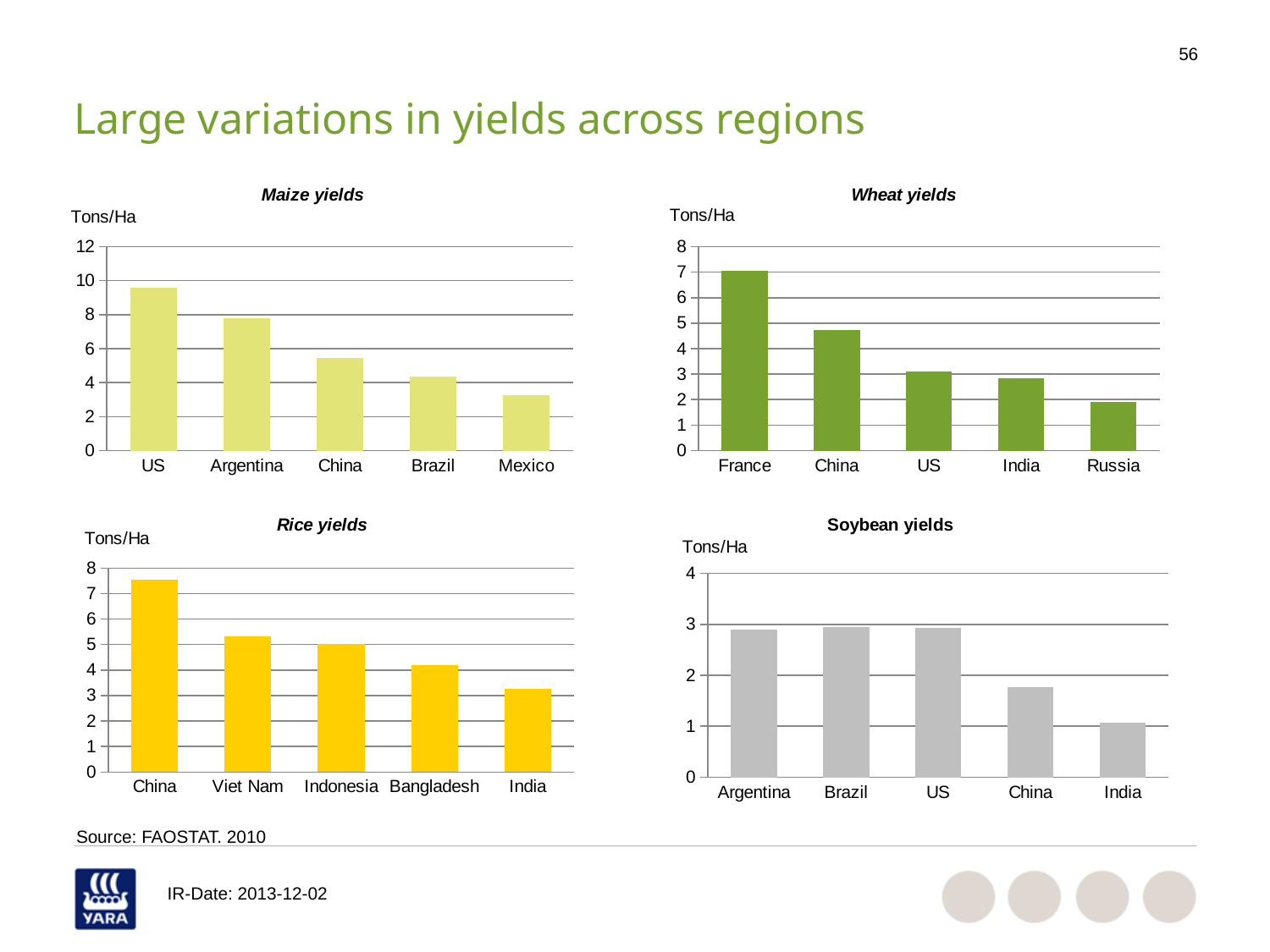
In the Soybean yields chart, which country has the lowest yield? India How many countries are shown in the Rice yields chart? 5 In the Maize yields chart, which country has the highest yield? US In the Soybean yields chart, is the value for China greater or less than 2? less In the Rice yields chart, is the value for China greater or less than 7? greater In the Wheat yields chart, which country has the highest yield? France In the Maize yields chart, which country has the lowest yield? Mexico What kind of chart is the Wheat yields chart? bar chart In the Rice yields chart, which country has the lowest yield? India In the Wheat yields chart, which is larger, the value for China or the value for US? China